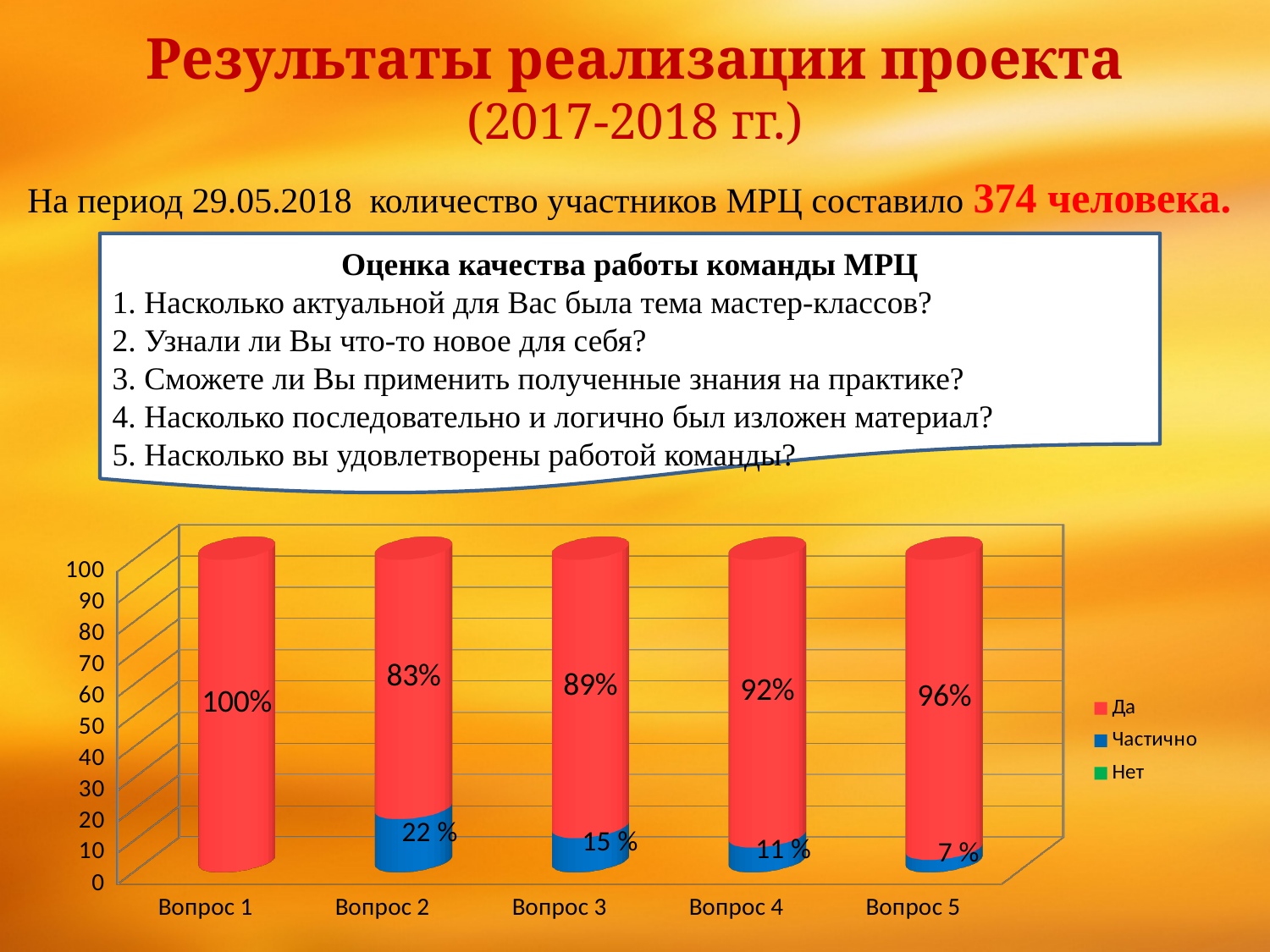
Which category has the highest value for the "Да" series? Вопрос 1 What is the value of the "Да" series for Вопрос 2? 83% How many categories are shown on the x axis? 5 What is the value of the "Частично" series for Вопрос 5? 7 % Which category has the lowest value for the "Да" series? Вопрос 2 What is the difference between the "Да" values for Вопрос 5 and Вопрос 4? 4% What is the value of the "Да" series for Вопрос 1? 100% What kind of chart is shown on the slide? Stacked bar chart Which is larger: the "Да" value for Вопрос 3 or for Вопрос 4? Вопрос 4 What is the value of the "Частично" series for Вопрос 3? 15 % How many series does the legend list? 3 Which category has the highest value for the "Частично" series? Вопрос 2